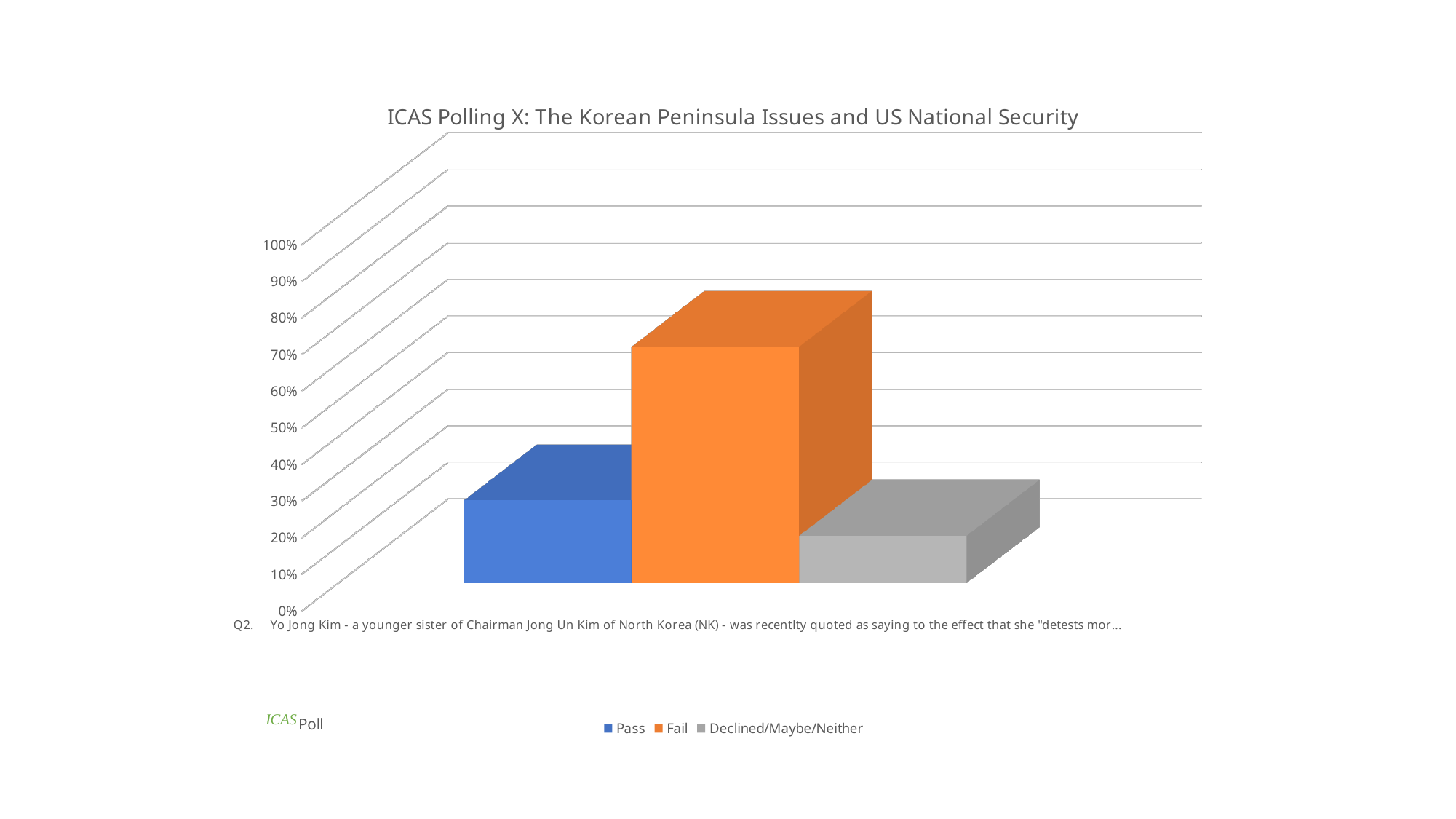
Is the value for Pass greater or less than 10%? greater What kind of chart is shown on the slide? bar chart How many series does the legend list? 3 Which is larger, the value for Pass or the value for Declined/Maybe/Neither? Pass Which is larger, the value for Pass or the value for Fail? Fail Which series has the lowest value? Declined/Maybe/Neither Is the value for Fail greater or less than 50%? greater What colour represents the Fail series? orange What is the title of the chart? ICAS Polling X: The Korean Peninsula Issues and US National Security Which series has the highest value? Fail